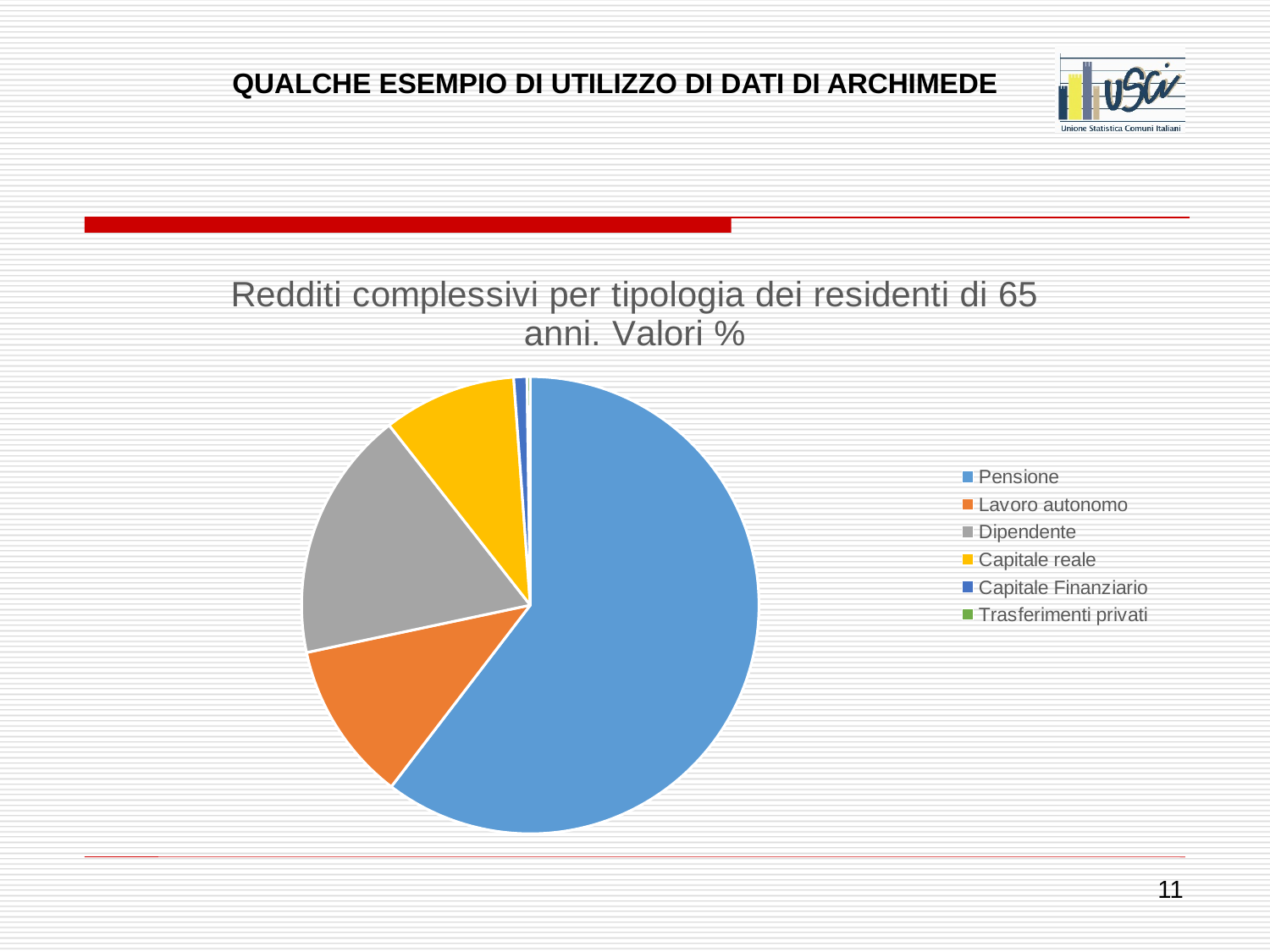
Which slice is larger, Capitale reale or Capitale Finanziario? Capitale reale Is the Pensione slice larger or smaller than all the other slices combined? larger Which category has the largest slice of the pie? Pensione Which slice is larger, Lavoro autonomo or Capitale reale? Lavoro autonomo What kind of chart is shown on the slide? pie chart Which legend entry is listed last in the pie chart's legend? Trasferimenti privati How many categories does the legend of the pie chart list? 6 What is the title of the chart? Redditi complessivi per tipologia dei residenti di 65 anni. Valori % What colour is used for the Capitale reale slice? yellow